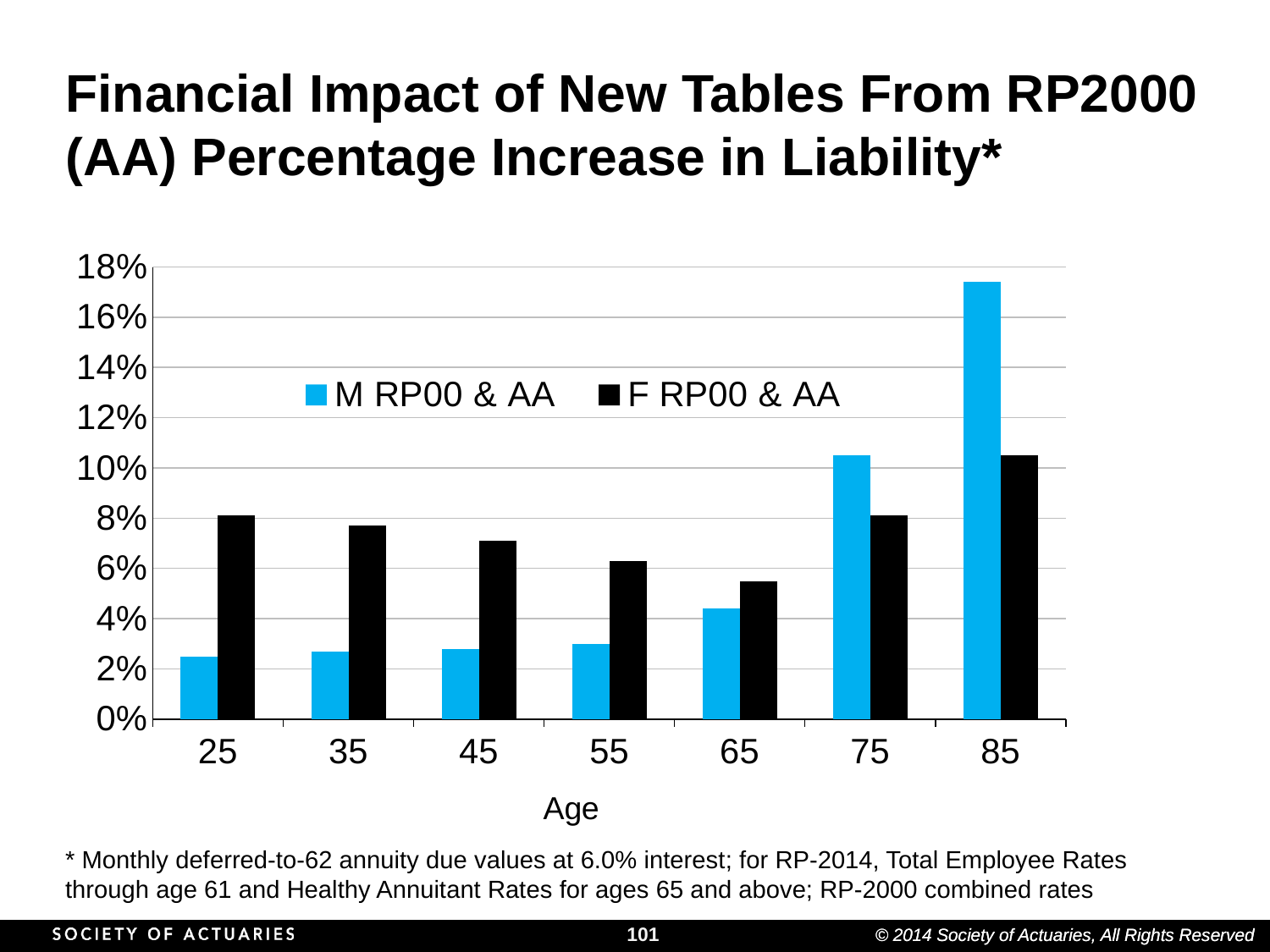
What is the title of the x axis? Age How many series does the legend list? 2 At which age is the F RP00 & AA value highest? 85 Is the F RP00 & AA value at age 25 greater or less than 10%? less Is the M RP00 & AA value at age 65 greater or less than 6%? less At which age is the F RP00 & AA value lowest? 65 How many age categories are shown on the x axis? 7 What kind of chart is shown on the slide? bar chart Is the M RP00 & AA value at age 85 greater or less than 16%? greater At age 75, which series has the larger value, M RP00 & AA or F RP00 & AA? M RP00 & AA At age 25, which series has the larger value, M RP00 & AA or F RP00 & AA? F RP00 & AA At which age is the M RP00 & AA value highest? 85